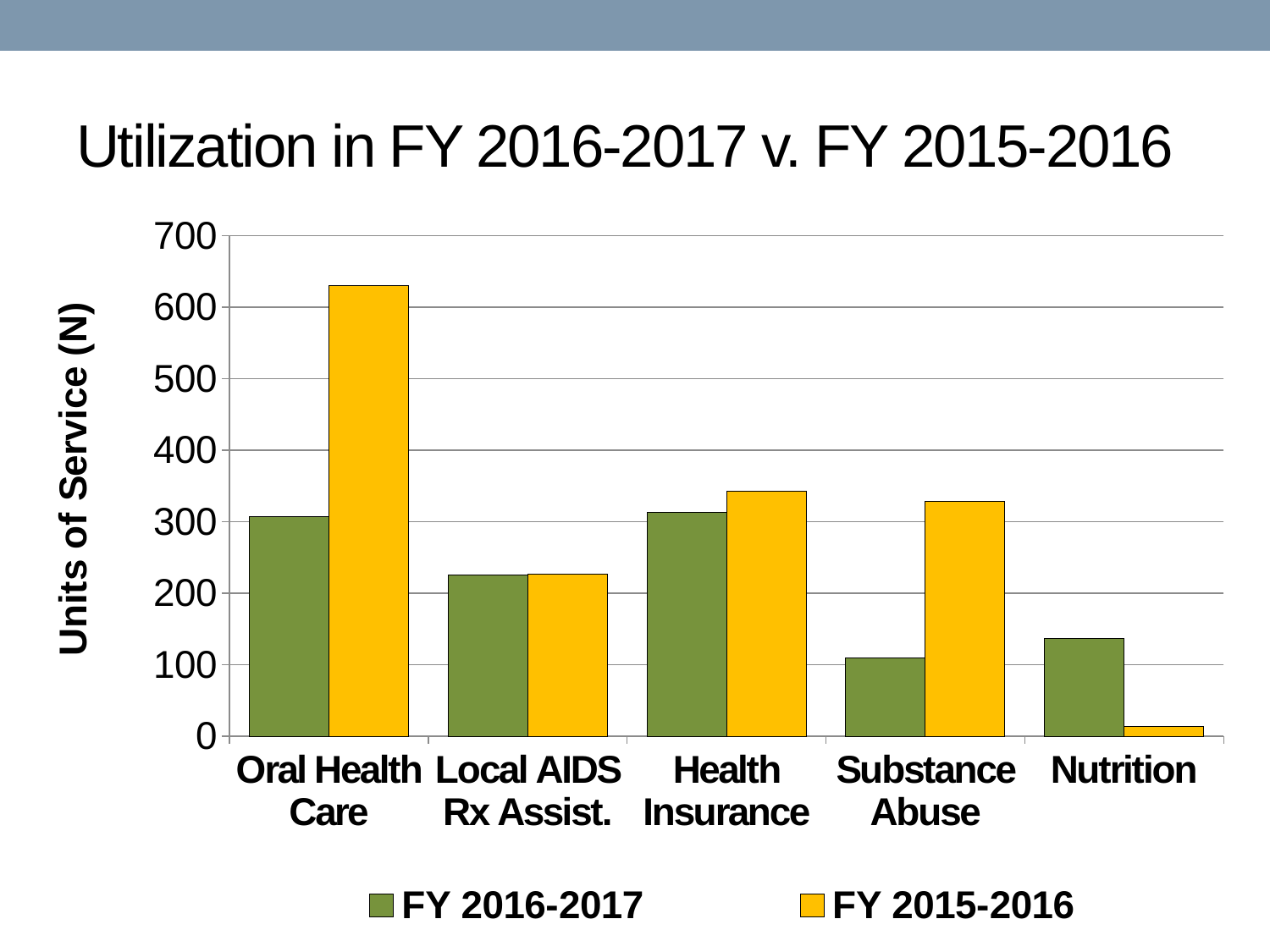
Is the FY 2015-2016 value for Oral Health Care greater or less than 600? greater What kind of chart is shown on the slide? bar chart Which category has the lowest FY 2015-2016 value? Nutrition Which category has the highest FY 2015-2016 value? Oral Health Care For Nutrition, which series has the larger value, FY 2016-2017 or FY 2015-2016? FY 2016-2017 Is the FY 2016-2017 value for Substance Abuse greater or less than 200? less How many series does the legend list? 2 What is the title of the y axis? Units of Service (N) How many service categories are shown on the x axis? 5 Which category has the lowest FY 2016-2017 value? Substance Abuse Is the FY 2015-2016 value for Nutrition greater or less than 100? less